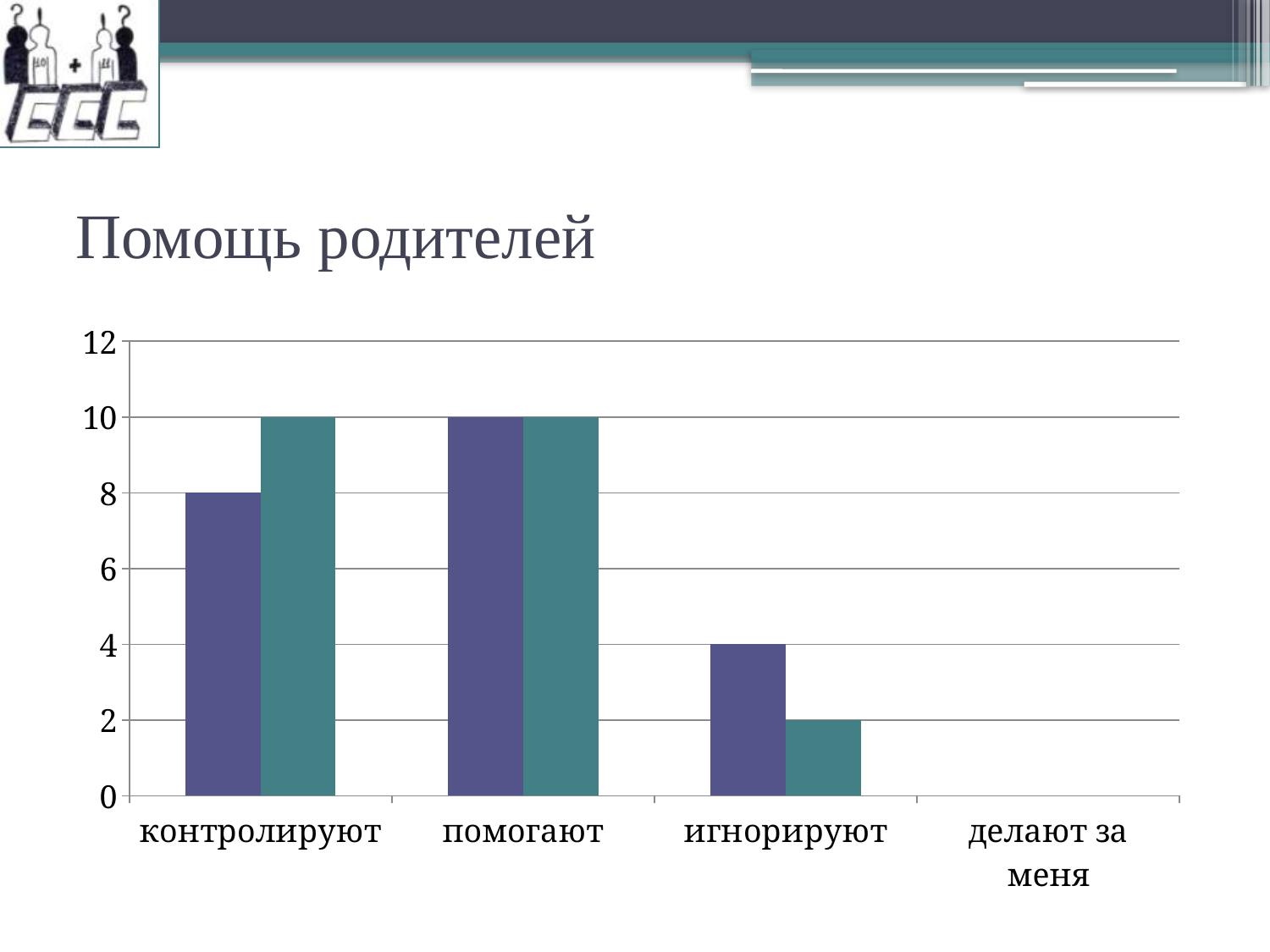
What is the title of the chart on the slide? Помощь родителей Is the purple bar for 'контролируют' greater or less than 6? greater What is the difference between the teal and purple bars for 'контролируют'? 2 What kind of chart is shown on the slide? bar chart How many categories are shown on the x axis of the chart? 4 What is the value of the purple bar for 'контролируют'? 8 For 'игнорируют', which bar is larger, the purple one or the teal one? purple Which category has the lowest teal bar among those with visible bars? игнорируют What is the value of the teal bar for 'контролируют'? 10 What is the value of the teal bar for 'игнорируют'? 2 Which category has the highest purple bar? помогают What is the value of the purple bar for 'игнорируют'? 4